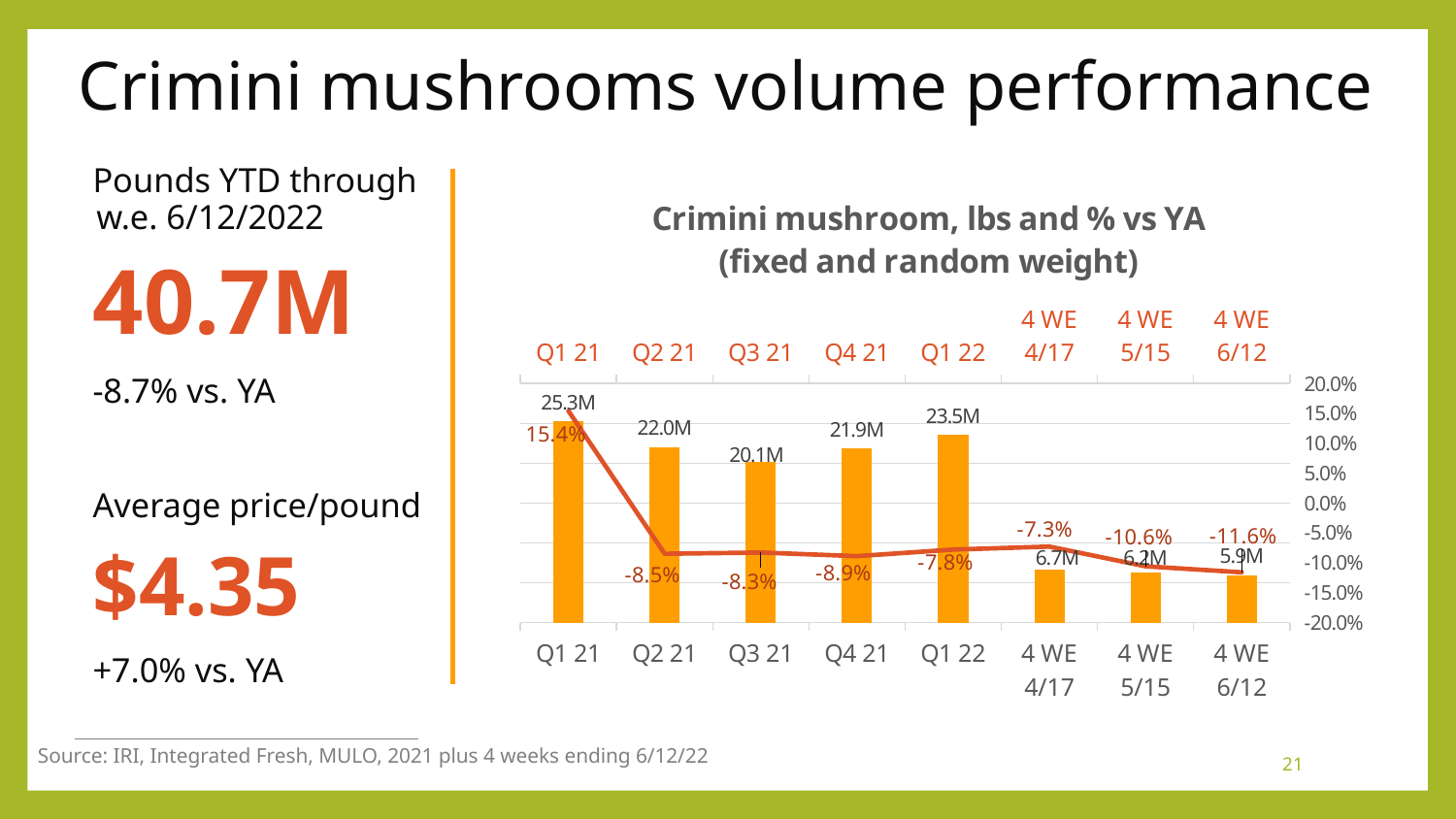
What is the % vs YA value for the 4 WE 6/12 period? -11.6% What is the difference in pounds between Q1 22 and Q4 21? 1.7M Is the % vs YA value for Q1 21 greater or less than 10.0%? greater Which is larger, the volume for Q2 21 or Q3 21? Q2 21 What is the % vs YA value for Q4 21? -8.9% What is the volume in pounds for the 4 WE 6/12 period? 5.9M What is the volume in pounds for Q1 21? 25.3M What is the title of the chart? Crimini mushroom, lbs and % vs YA (fixed and random weight) Which period has the lowest % vs YA value? 4 WE 6/12 Which period has the highest volume in pounds? Q1 21 What kind of chart is this? Combined bar and line chart How many periods are shown on the x axis? 8